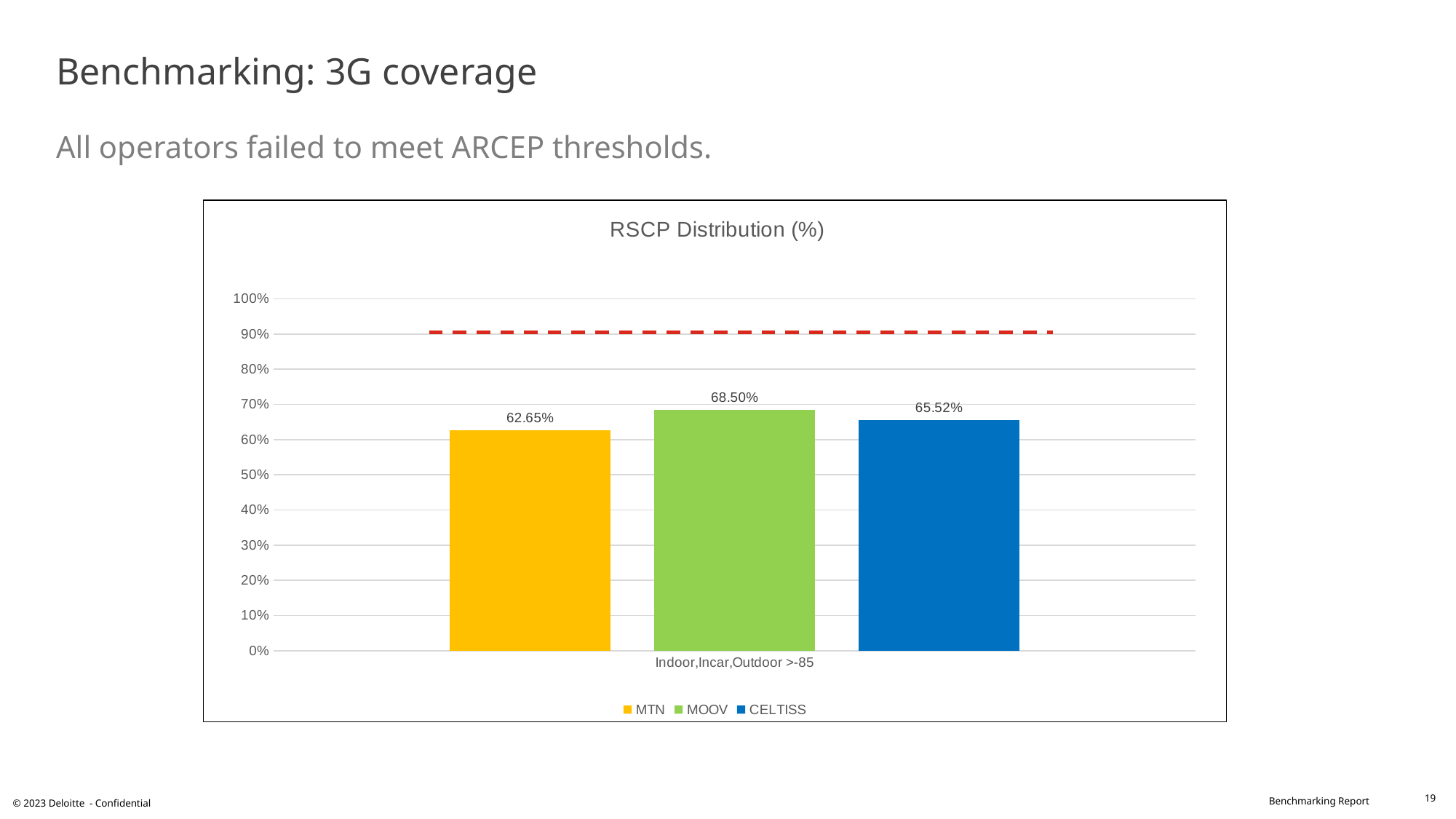
What is the difference between the CELTISS and MTN values in the RSCP Distribution (%) chart? 2.87% What is the value for CELTISS in the RSCP Distribution (%) chart? 65.52% Which operator has the highest value in the RSCP Distribution (%) chart? MOOV What is the difference between the MOOV and MTN values in the RSCP Distribution (%) chart? 5.85% Is the value for MOOV in the RSCP Distribution (%) chart greater or less than 90%? less Which is larger in the RSCP Distribution (%) chart, the value for CELTISS or the value for MTN? CELTISS What is the category label on the x axis of the RSCP Distribution (%) chart? Indoor,Incar,Outdoor >-85 How many series does the legend of the RSCP Distribution (%) chart list? 3 What is the value for MOOV in the RSCP Distribution (%) chart? 68.50% What is the value for MTN in the RSCP Distribution (%) chart? 62.65% Which operator has the lowest value in the RSCP Distribution (%) chart? MTN What kind of chart is the RSCP Distribution (%) chart? Bar chart